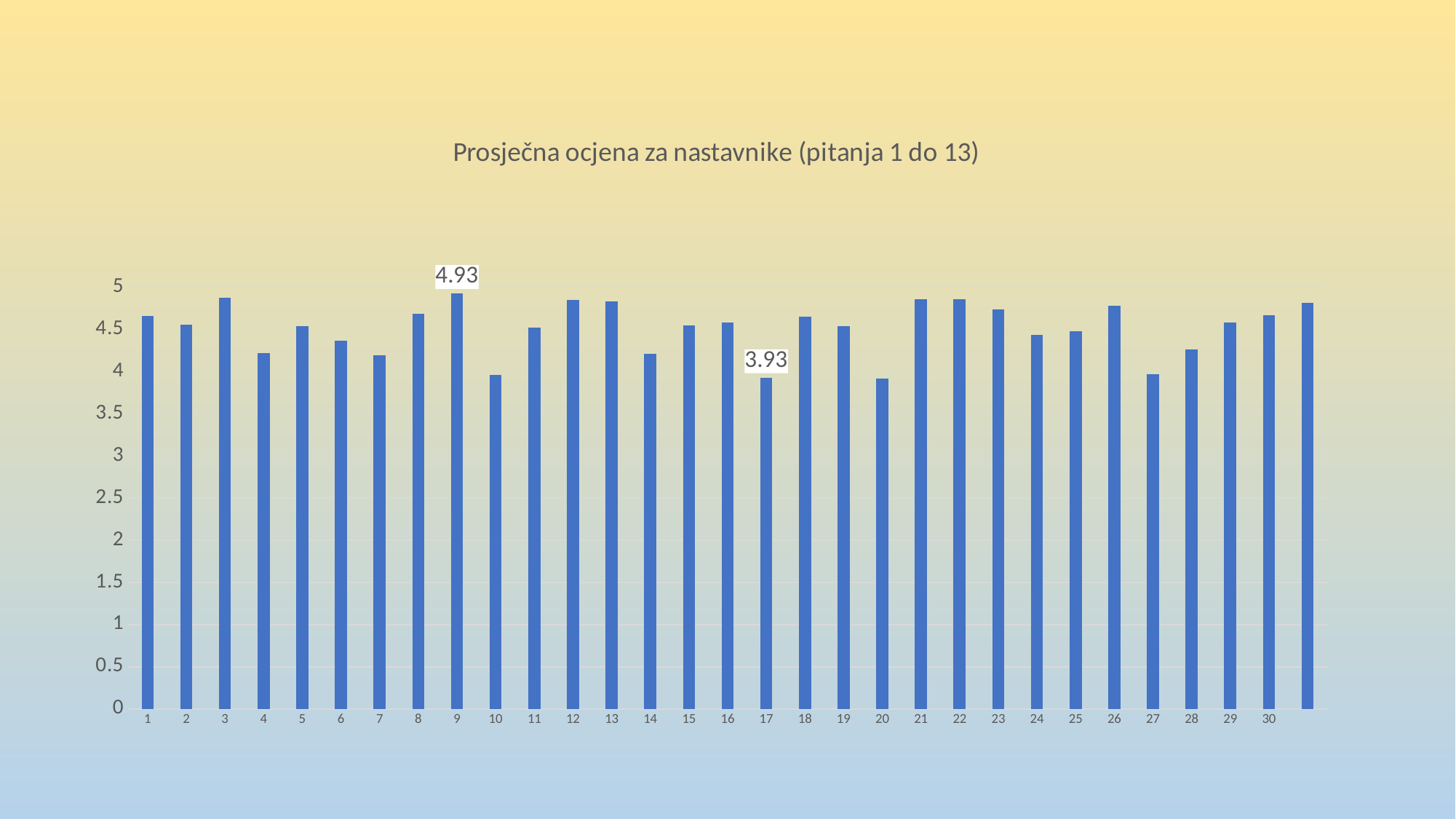
What is the difference between the values for category 9 and category 17? 1.00 Which is larger, the value for category 17 or the value for category 9? 9 What type of chart is shown on the slide? bar chart What is the value for category 9? 4.93 Which category has the highest value? 9 Is the value for category 12 greater or less than 4.5? greater Which is larger, the value for category 3 or the value for category 4? 3 What is the title of the chart? Prosječna ocjena za nastavnike (pitanja 1 do 13) Is the value for category 4 greater or less than 4.5? less Is the value for category 3 greater or less than 4.5? greater What is the value for category 17? 3.93